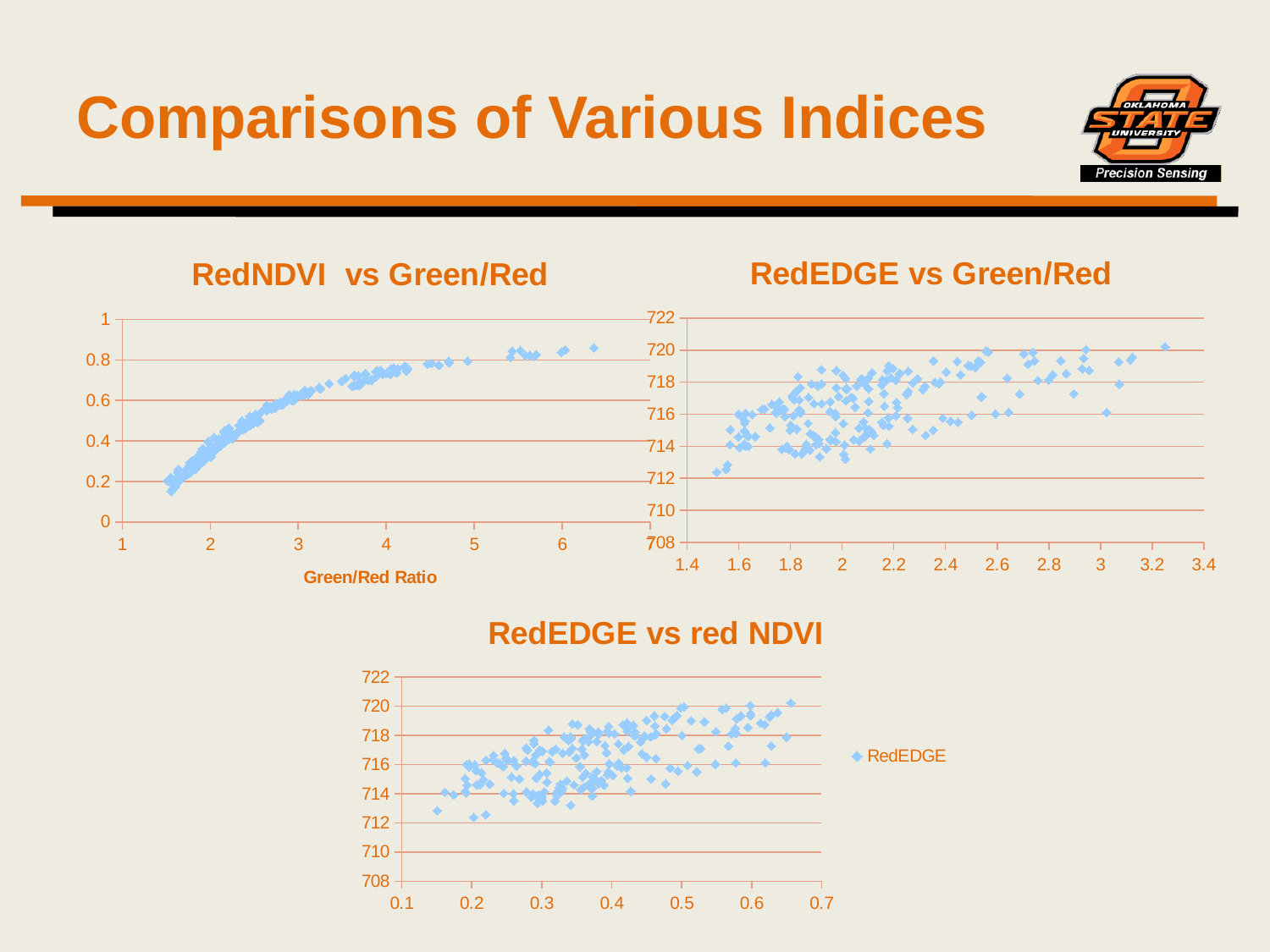
In the 'RedNDVI vs Green/Red' chart, is the lowest plotted value greater or less than 0.4? less In the 'RedEDGE vs red NDVI' chart, do the plotted values generally rise or fall as the x-axis value increases? rise In the 'RedEDGE vs Green/Red' chart, do the plotted values generally rise or fall as the x-axis value increases? rise How many series does the legend of the 'RedEDGE vs red NDVI' chart list? 1 How many charts are shown on the slide? 3 In the 'RedEDGE vs Green/Red' chart, is the highest plotted value greater or less than 718? greater What entry does the legend of the 'RedEDGE vs red NDVI' chart list? RedEDGE In the 'RedNDVI vs Green/Red' chart, do the plotted values rise or fall as the Green/Red Ratio increases? rise What is the x-axis title of the 'RedNDVI vs Green/Red' chart? Green/Red Ratio In the 'RedEDGE vs red NDVI' chart, is the lowest plotted value greater or less than 714? less What kind of chart is 'RedNDVI vs Green/Red'? scatter chart